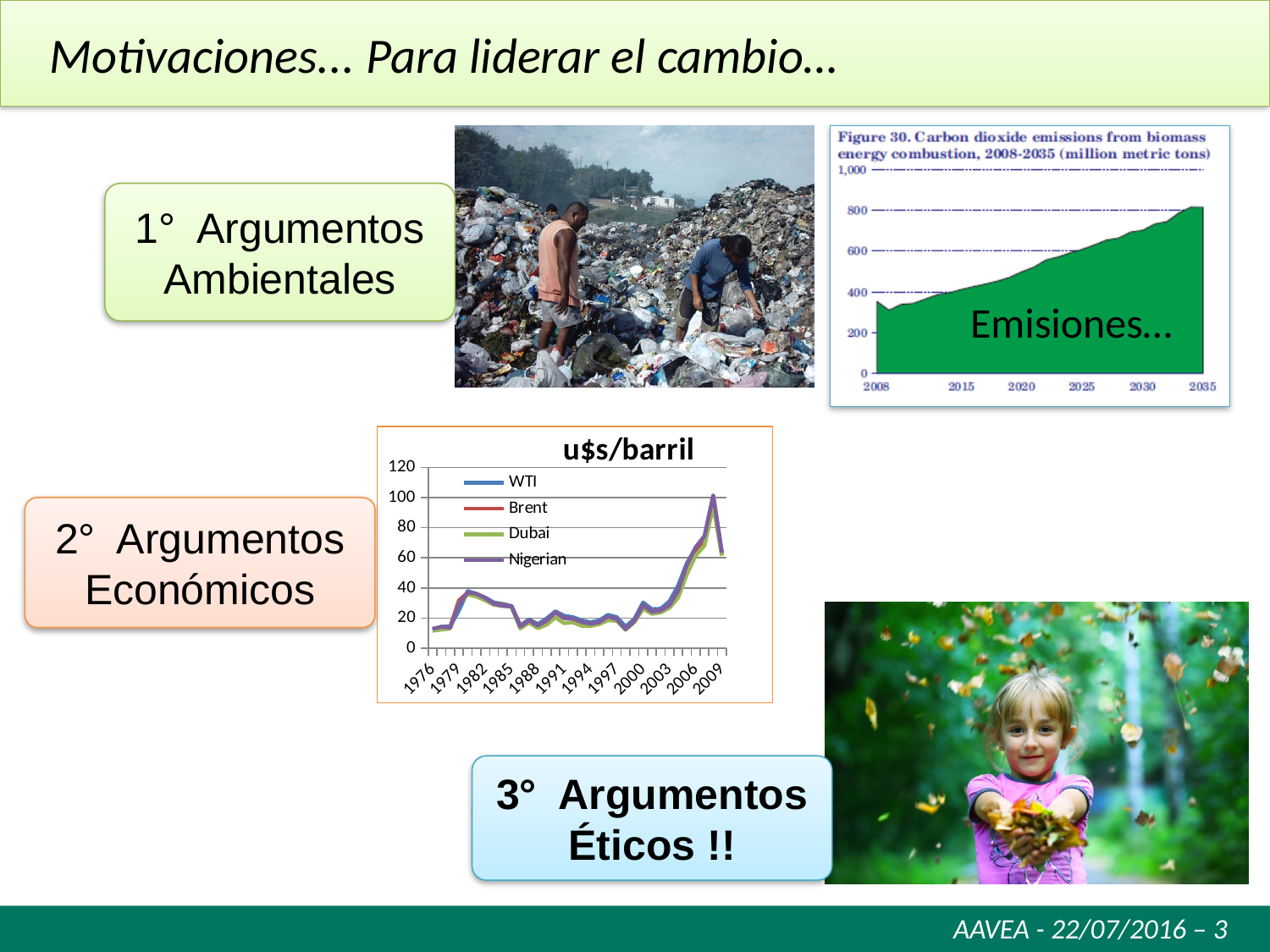
In the 'Figure 30' carbon dioxide emissions chart, do the values rise or fall from 2008 to 2035? rise What kind of chart is the 'u$s/barril' chart? line chart Which series are listed in the legend of the 'u$s/barril' chart? WTI, Brent, Dubai, Nigerian How many series does the legend of the 'u$s/barril' chart list? 4 How many year labels are shown on the x axis of the 'u$s/barril' chart? 12 In the 'u$s/barril' chart, is the value for 2009 greater or less than 40? greater In the 'Figure 30' carbon dioxide emissions chart, is the value for 2035 greater or less than 600? greater In the 'u$s/barril' chart, is the peak value around 2008 greater or less than 80? greater What is the title of the chart in the top right of the slide? Figure 30. Carbon dioxide emissions from biomass energy combustion, 2008-2035 (million metric tons)